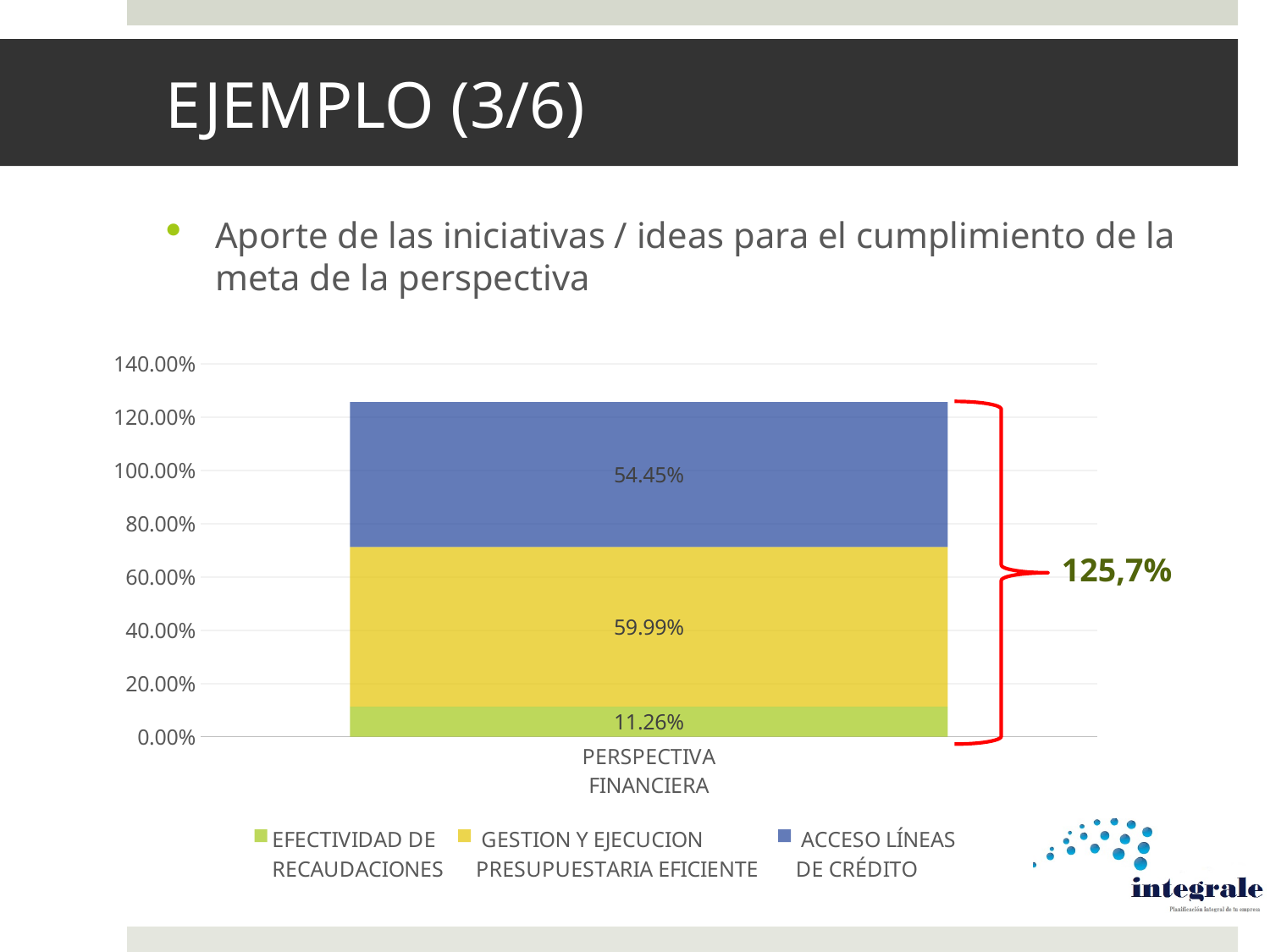
What is the value for EFECTIVIDAD DE RECAUDACIONES in the PERSPECTIVA FINANCIERA bar? 11.26% Which series contributes the largest value to the PERSPECTIVA FINANCIERA bar? GESTION Y EJECUCION PRESUPUESTARIA EFICIENTE How many categories are shown on the x axis? 1 Which is larger, the value for ACCESO LÍNEAS DE CRÉDITO or the value for EFECTIVIDAD DE RECAUDACIONES? ACCESO LÍNEAS DE CRÉDITO What is the total of the stacked PERSPECTIVA FINANCIERA bar, as annotated on the slide? 125,7% What is the highest value shown on the y axis? 140.00% Which series contributes the smallest value to the PERSPECTIVA FINANCIERA bar? EFECTIVIDAD DE RECAUDACIONES What kind of chart is shown on the slide? Stacked bar chart What is the value for GESTION Y EJECUCION PRESUPUESTARIA EFICIENTE in the PERSPECTIVA FINANCIERA bar? 59.99% What is the value for ACCESO LÍNEAS DE CRÉDITO in the PERSPECTIVA FINANCIERA bar? 54.45% What is the difference between the GESTION Y EJECUCION PRESUPUESTARIA EFICIENTE value and the ACCESO LÍNEAS DE CRÉDITO value? 5.54% How many series does the legend list? 3